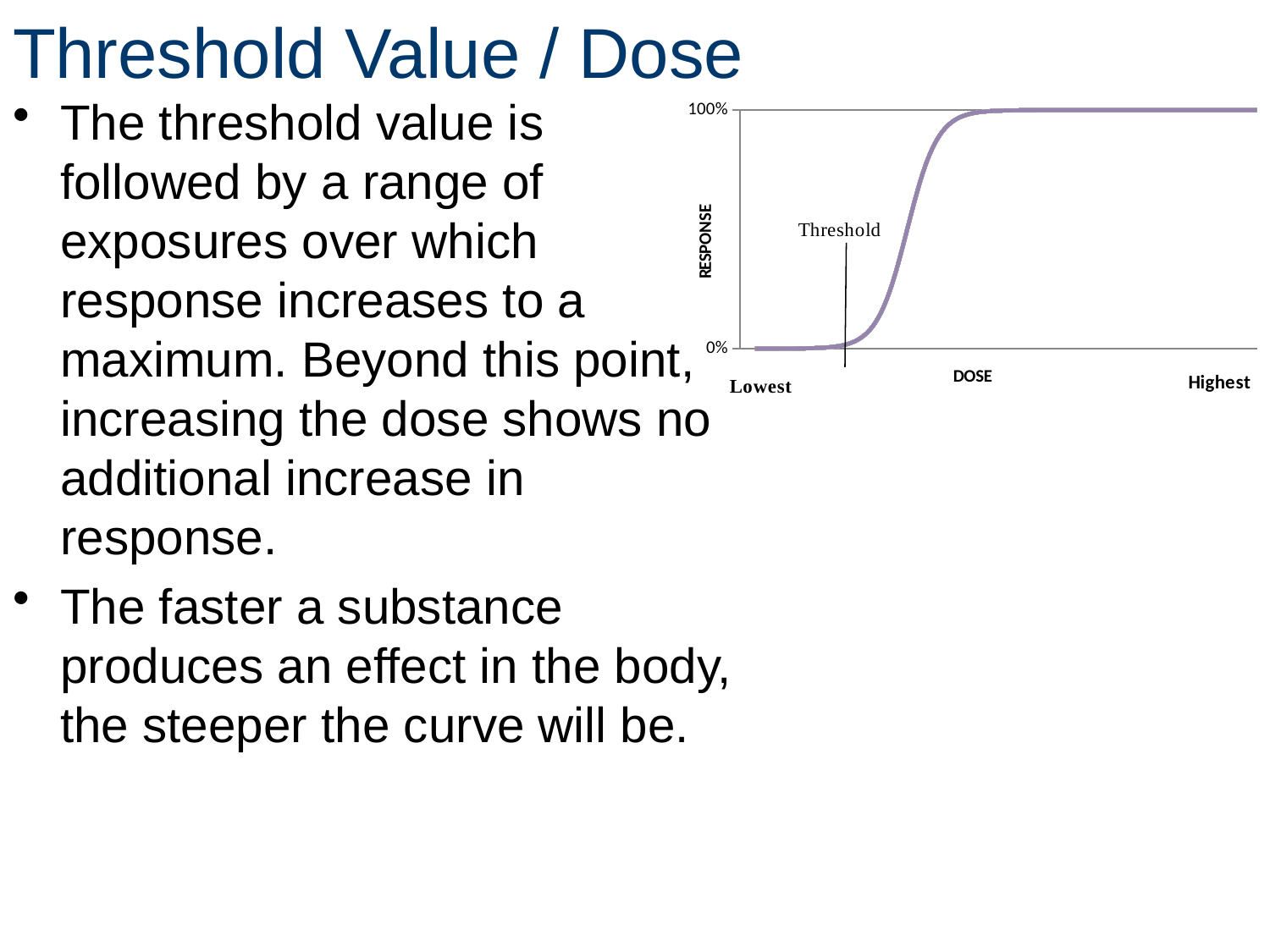
What kind of chart is shown on the slide? line chart What is the label of the horizontal axis of the chart? DOSE Which dose has the higher response, Lowest or Highest? Highest What is the response value at the Lowest dose? 0% Is the response at the Threshold dose greater or less than 100%? less At which labelled dose is the response highest? Highest At which labelled dose is the response lowest? Lowest What is the response value at the Highest dose? 100% What is the label of the vertical axis of the chart? RESPONSE Does the response rise or fall as dose increases from Lowest to Highest? rise Is the response at the Highest dose greater or less than 0%? greater